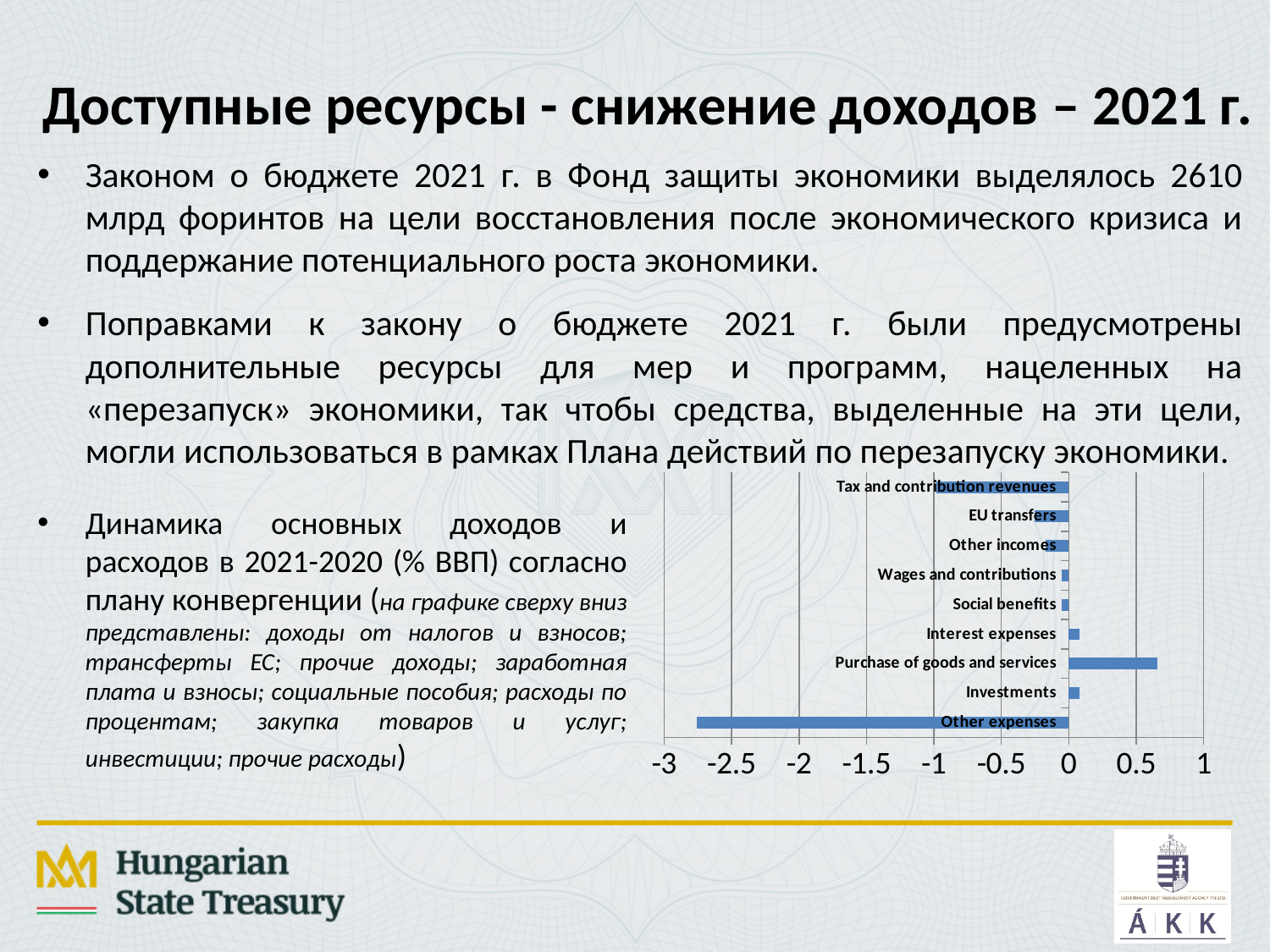
Which is larger, the value for Tax and contribution revenues or the value for Other expenses? Tax and contribution revenues Which is larger, the value for Purchase of goods and services or the value for Interest expenses? Purchase of goods and services Is the value for Other expenses greater or less than -2.5? less How many categories are plotted in the chart? 9 What is the lowest value shown on the horizontal axis of the chart? -3 Which category has the lowest (most negative) value in the chart? Other expenses Is the value for Purchase of goods and services greater or less than 0.5? greater What kind of chart is shown on the slide? bar chart Which category is listed at the top of the chart? Tax and contribution revenues Which category has the highest value in the chart? Purchase of goods and services Is the value for Tax and contribution revenues greater or less than -0.5? less